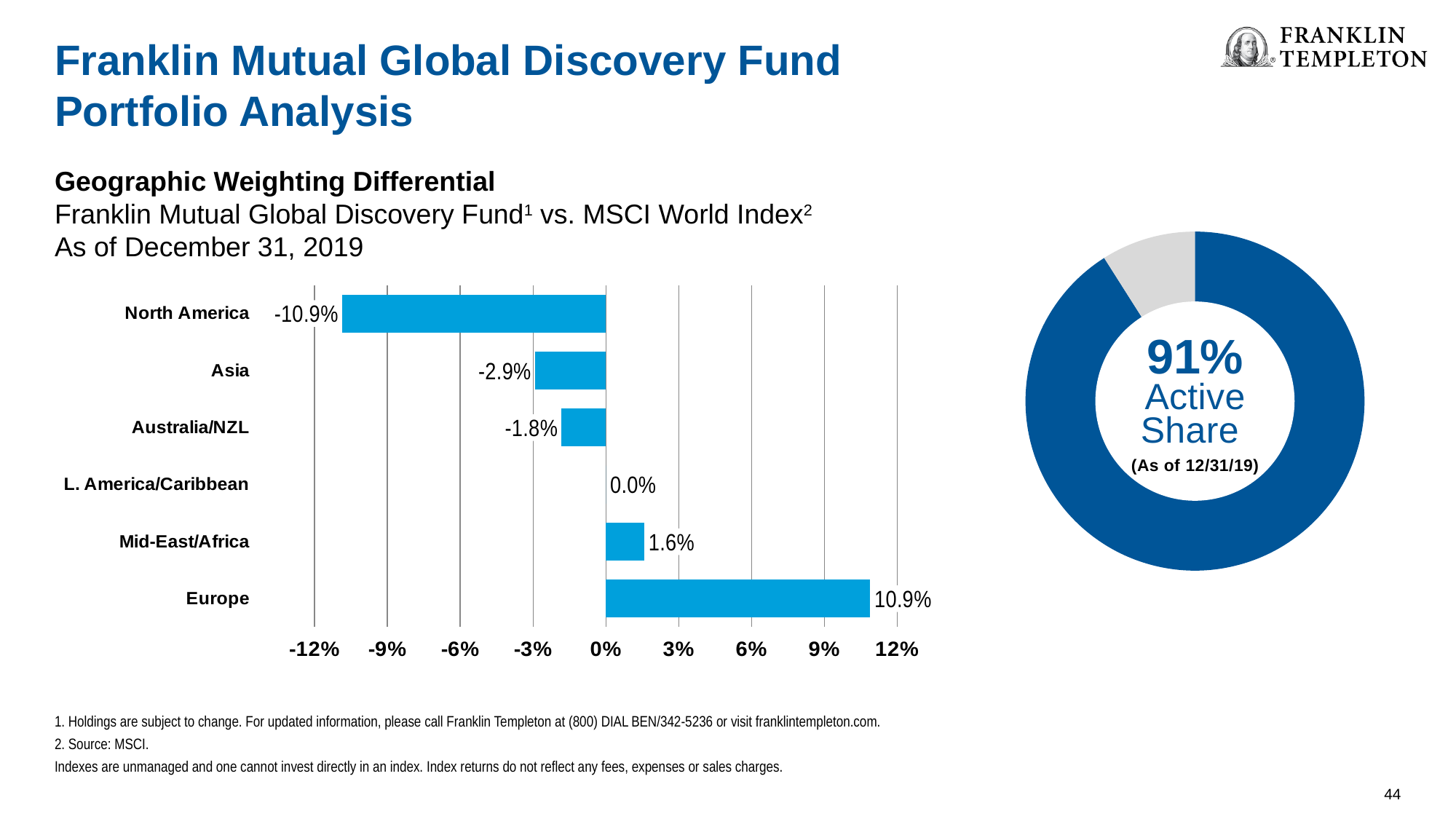
In the donut chart on the right, what Active Share percentage is shown? 91% In the Geographic Weighting Differential chart, what is the value for Mid-East/Africa? 1.6% In the Geographic Weighting Differential chart, what is the value for L. America/Caribbean? 0.0% What kind of chart is the Geographic Weighting Differential chart? Bar chart In the Geographic Weighting Differential chart, what is the value for Asia? -2.9% In the Geographic Weighting Differential chart, which region has the highest value? Europe In the Geographic Weighting Differential chart, which region has the lowest value? North America In the Geographic Weighting Differential chart, which has the larger value, Asia or Australia/NZL? Australia/NZL How many regions are shown in the Geographic Weighting Differential chart? 6 In the Geographic Weighting Differential chart, what is the value for North America? -10.9% In the Geographic Weighting Differential chart, what is the difference between the values for Europe and Mid-East/Africa? 9.3% In the Geographic Weighting Differential chart, is the value for Europe greater or less than 9%? greater